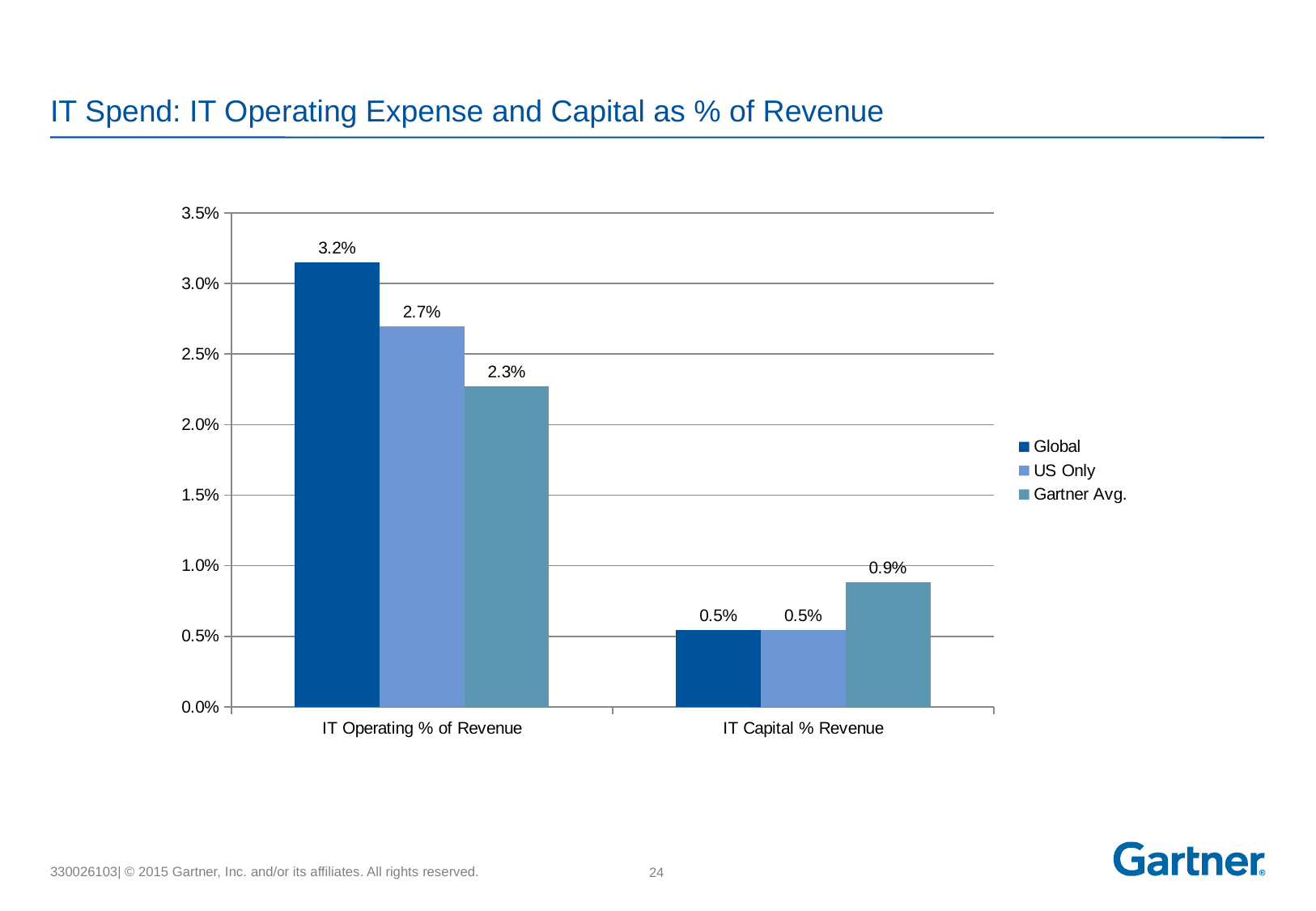
What is the US Only value for IT Operating % of Revenue? 2.7% Which series has the highest value for IT Capital % Revenue? Gartner Avg. Which is larger for IT Capital % Revenue: the Gartner Avg. value or the Global value? Gartner Avg. What is the difference between the Global and Gartner Avg. values for IT Operating % of Revenue? 0.9% How many series does the legend list? 3 Which series has the lowest value for IT Operating % of Revenue? Gartner Avg. How many categories are shown on the x axis? 2 What is the Gartner Avg. value for IT Capital % Revenue? 0.9% What is the Global value for IT Operating % of Revenue? 3.2% Is the Global value for IT Operating % of Revenue greater or less than 3.0%? greater What kind of chart is shown on the slide? Bar chart Which series has the highest value for IT Operating % of Revenue? Global